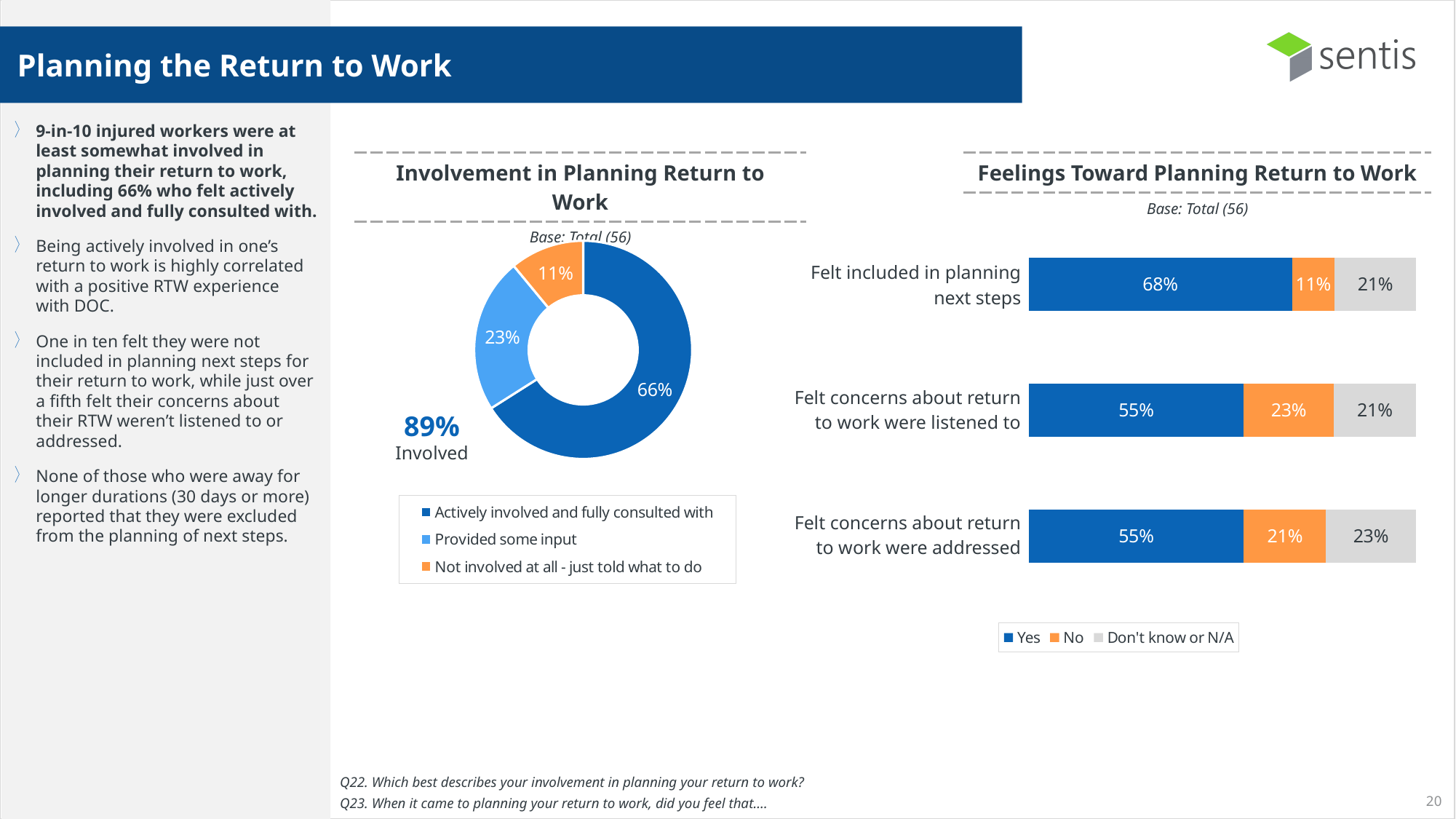
In the 'Feelings Toward Planning Return to Work' chart, what percentage said No to 'Felt concerns about return to work were listened to'? 23% In the 'Feelings Toward Planning Return to Work' chart, what percentage said Yes to 'Felt included in planning next steps'? 68% In the 'Feelings Toward Planning Return to Work' chart, which statement has the highest Yes percentage? Felt included in planning next steps In the 'Feelings Toward Planning Return to Work' chart, what is the 'Don't know or N/A' value for 'Felt concerns about return to work were addressed'? 23% In the 'Involvement in Planning Return to Work' chart, which category has the smallest share? Not involved at all - just told what to do In the 'Feelings Toward Planning Return to Work' chart, what is the difference between the Yes percentage for 'Felt included in planning next steps' and the Yes percentage for 'Felt concerns about return to work were addressed'? 13% In the 'Involvement in Planning Return to Work' chart, what percentage provided some input? 23% What kind of chart is 'Involvement in Planning Return to Work'? Doughnut chart How many categories does the legend of the 'Involvement in Planning Return to Work' chart list? 3 What kind of chart is 'Feelings Toward Planning Return to Work'? Stacked bar chart How many series does the legend of the 'Feelings Toward Planning Return to Work' chart list? 3 In the 'Involvement in Planning Return to Work' chart, what percentage were actively involved and fully consulted with? 66%